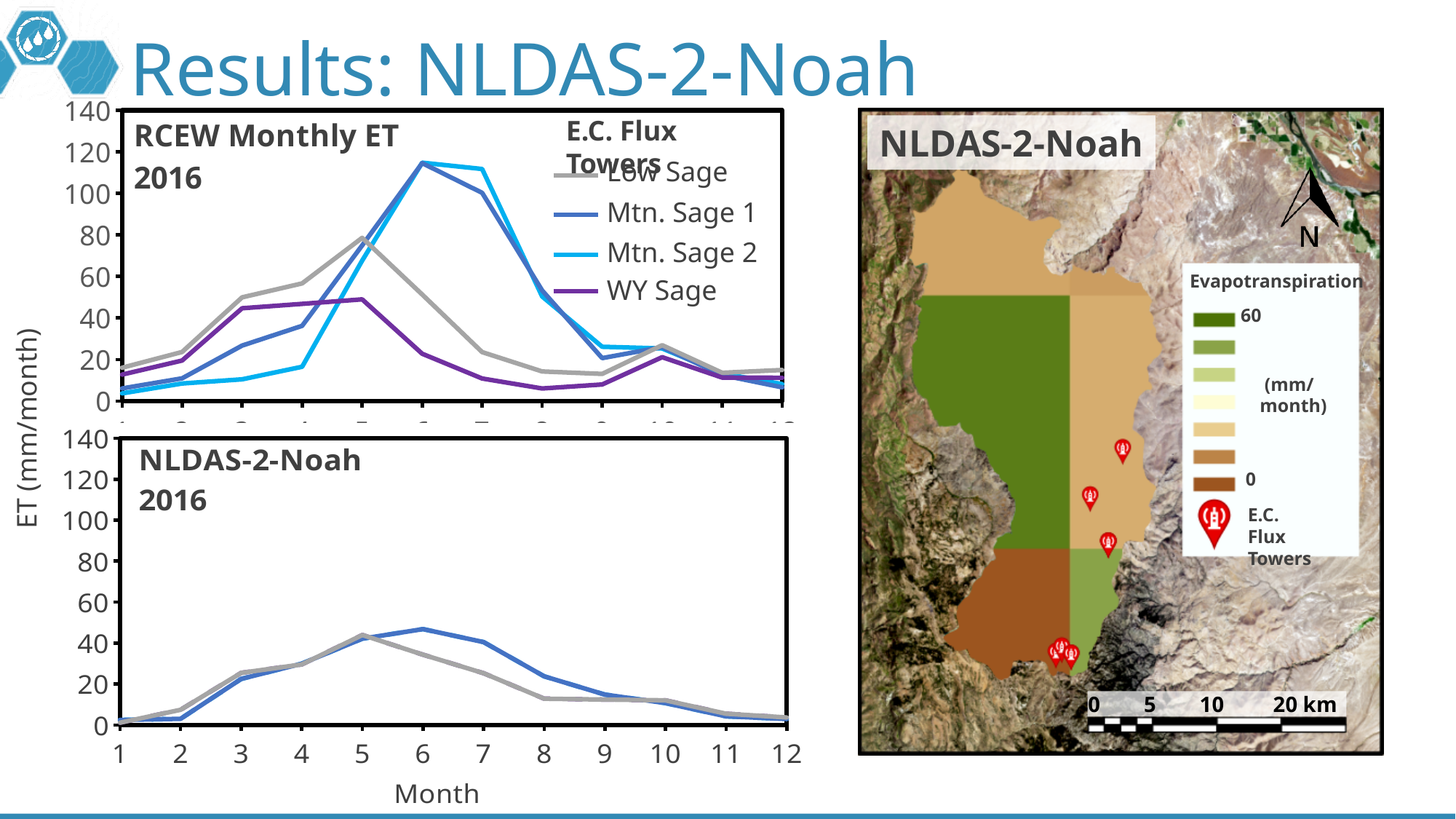
In the bottom chart 'NLDAS-2-Noah 2016', is the value of the blue line in month 6 greater or less than 40? greater What is the label on the shared y axis of the two line charts? ET (mm/month) What kind of chart is the top chart titled 'RCEW Monthly ET 2016'? line chart In the top chart 'RCEW Monthly ET 2016', is the value for Mtn. Sage 2 in month 3 greater or less than 20? less In the top chart 'RCEW Monthly ET 2016', how many series does the legend list? 4 In the top chart 'RCEW Monthly ET 2016', which series has the lowest peak value over the year? WY Sage In the top chart 'RCEW Monthly ET 2016', which is larger in month 5: Low Sage or WY Sage? Low Sage In the bottom chart 'NLDAS-2-Noah 2016', is the value of the grey line in month 8 greater or less than 20? less In the bottom chart 'NLDAS-2-Noah 2016', how many months are shown along the x axis? 12